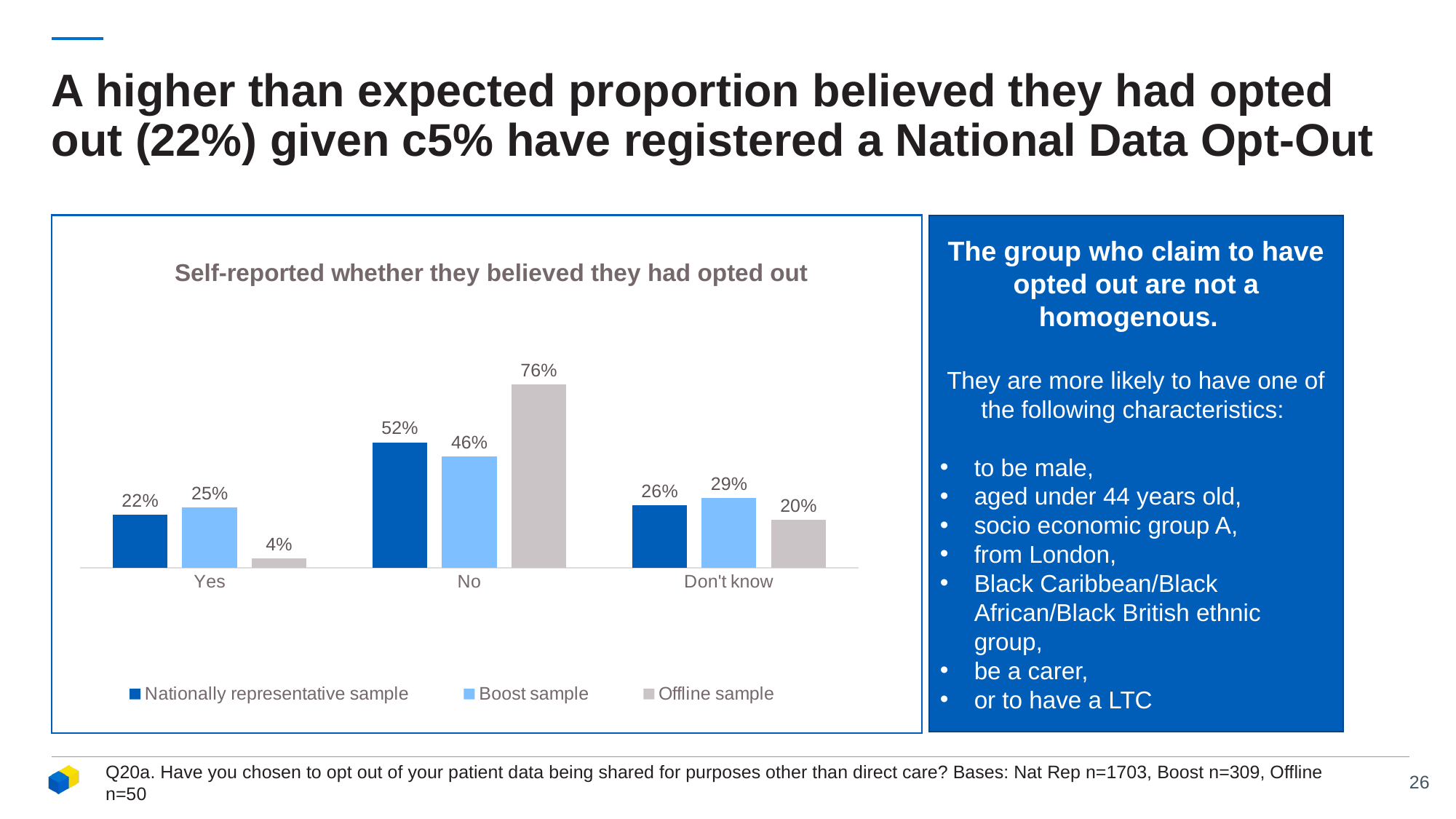
What is the title of the chart? Self-reported whether they believed they had opted out What is the difference between the Offline sample and the Nationally representative sample for 'No'? 24 percentage points Which response category has the highest value for the Offline sample? No What percentage of the Nationally representative sample answered 'Yes'? 22% What kind of chart is shown on the slide? Bar chart How many response categories are shown on the x axis? 3 What percentage of the Offline sample answered 'No'? 76% How many series does the legend list? 3 Which series is shown in light blue in the legend? Boost sample Which is larger for 'Yes': the Boost sample or the Offline sample? Boost sample Which response category has the lowest value for the Boost sample? Yes What percentage of the Boost sample answered 'Don't know'? 29%